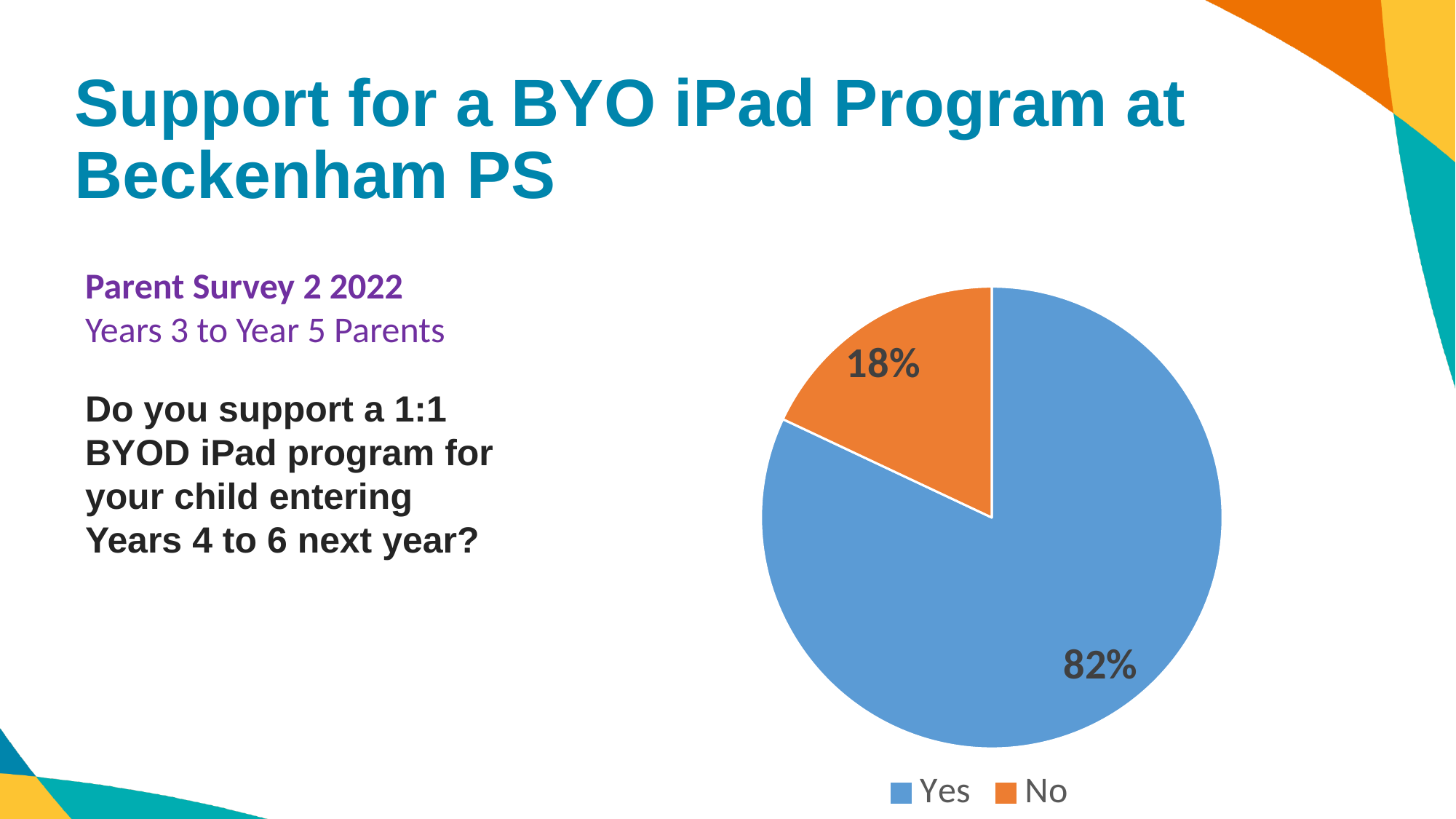
What colour is the Yes slice of the pie chart? blue What percentage of parents answered Yes? 82% What kind of chart is shown on the slide? pie chart Which is larger, the share for Yes or the share for No? Yes How many slices does the pie chart have? 2 What share of the pie does the No slice represent? 18% What colour is the No slice of the pie chart? orange Which response has the largest share of the pie? Yes Which response has the smallest share of the pie? No How many entries does the legend list? 2 What is the difference in percentage points between the Yes and No responses? 64 What percentage of parents answered No? 18%